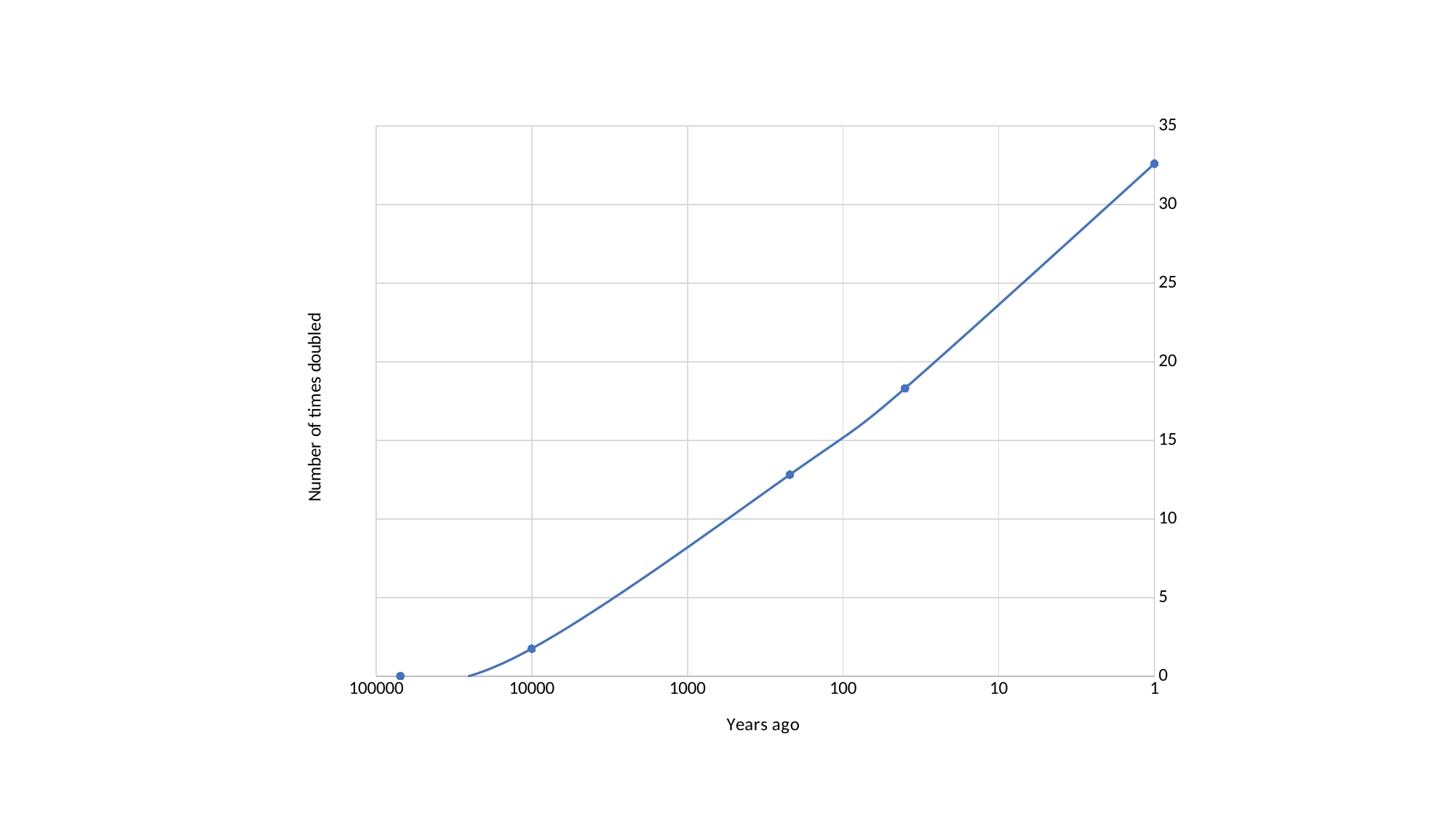
Is the value of the third data point from the left greater or less than 15? less Which is larger, the value at 1 year ago or the value at 10000 years ago? 1 year ago What is the title of the y axis? Number of times doubled Which x-axis value has the highest number of times doubled? 1 What is the title of the x axis? Years ago Does the number of times doubled rise or fall moving from left to right along the x axis? rise Is the value for 1 year ago greater or less than 30? greater Is the value for 10000 years ago greater or less than 5? less How many data points are plotted on the chart? 5 What is the highest tick value shown on the y axis? 35 What kind of chart is shown on the slide? line chart